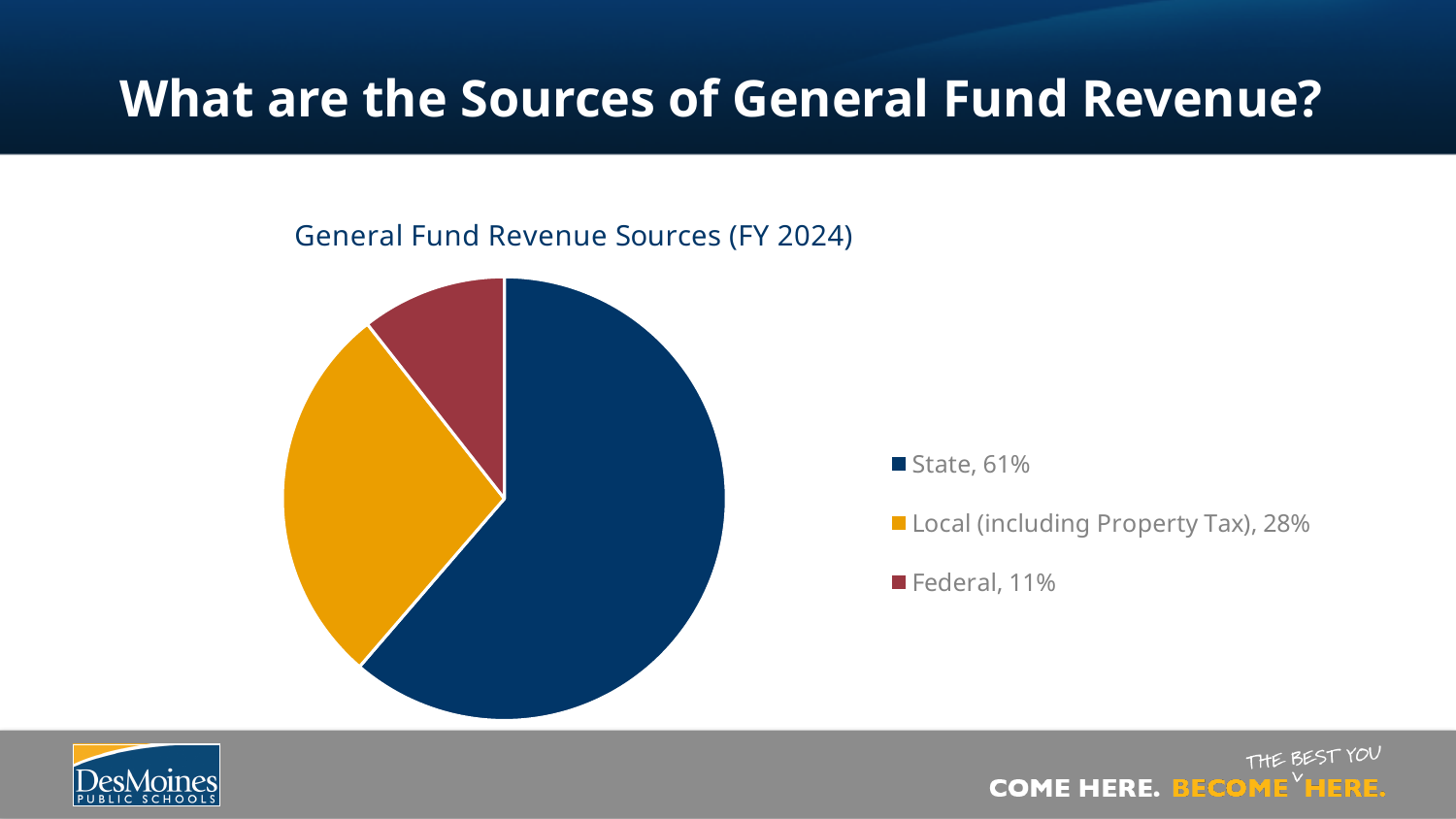
How many revenue sources are shown in the pie chart? 3 What share of General Fund revenue comes from State sources? 61% What type of chart is shown on the slide? Pie chart Which revenue source makes up the smallest share of the pie? Federal What colour is the slice representing Federal revenue? Red What share of General Fund revenue comes from Federal sources? 11% What is the difference in percentage points between the State share and the Local (including Property Tax) share? 33 What share of General Fund revenue comes from Local (including Property Tax) sources? 28% Which is larger, the Local (including Property Tax) share or the Federal share? Local (including Property Tax) What is the title of the chart? General Fund Revenue Sources (FY 2024) Which revenue source makes up the largest share of the pie? State What is the difference in percentage points between the Local (including Property Tax) share and the Federal share? 17